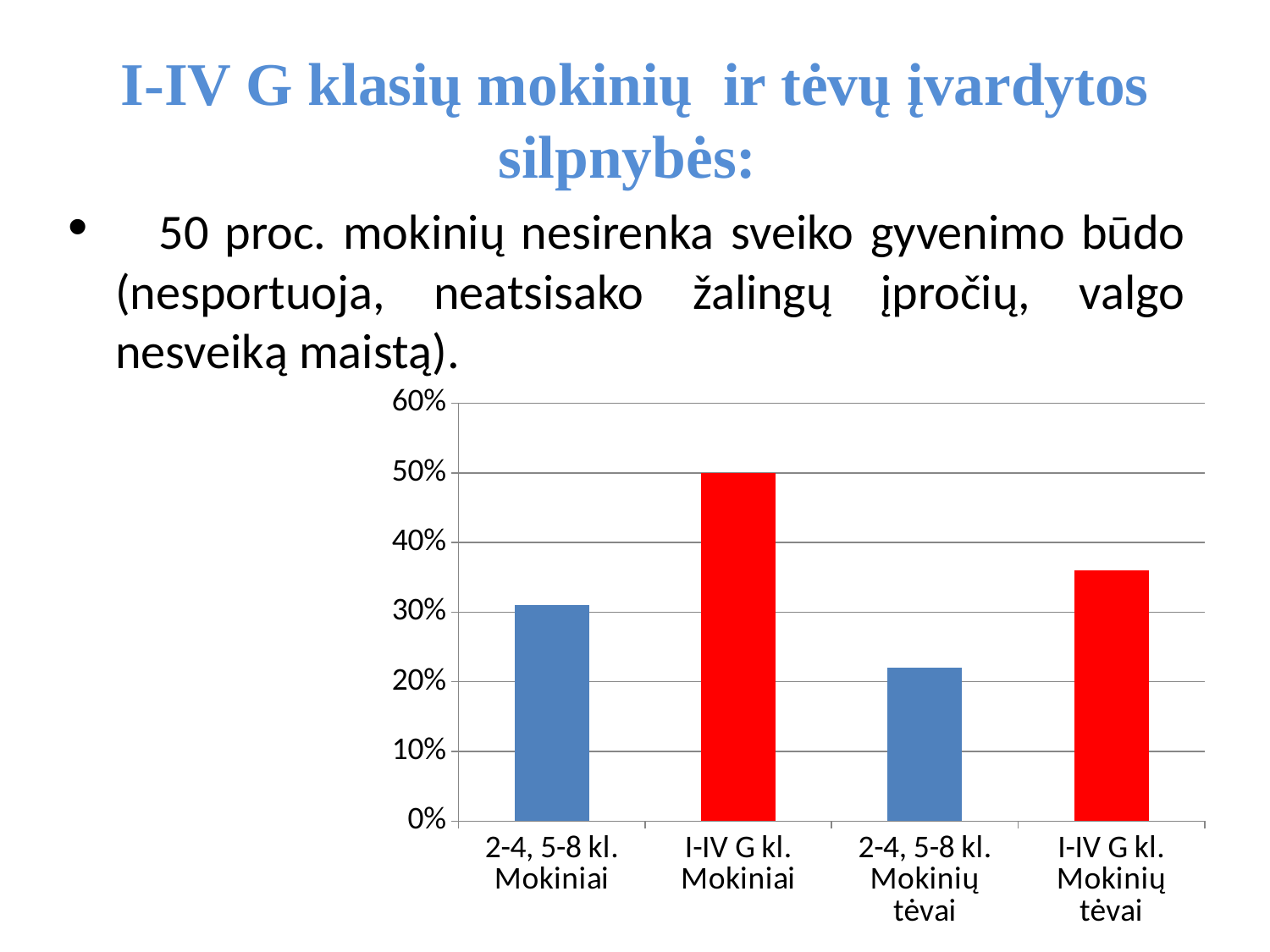
What is the value for I-IV G kl. Mokiniai? 50% Which category has the highest bar? I-IV G kl. Mokiniai Is the value for I-IV G kl. Mokinių tėvai greater or less than 40%? less Is the value for 2-4, 5-8 kl. Mokinių tėvai greater or less than 20%? greater Is the value for 2-4, 5-8 kl. Mokiniai greater or less than 40%? less Which is larger, the value for 2-4, 5-8 kl. Mokiniai or the value for 2-4, 5-8 kl. Mokinių tėvai? 2-4, 5-8 kl. Mokiniai Which category has the lowest bar? 2-4, 5-8 kl. Mokinių tėvai What kind of chart is shown on the slide? bar chart Which is larger, the value for I-IV G kl. Mokiniai or the value for I-IV G kl. Mokinių tėvai? I-IV G kl. Mokiniai How many categories are shown on the x axis of the chart? 4